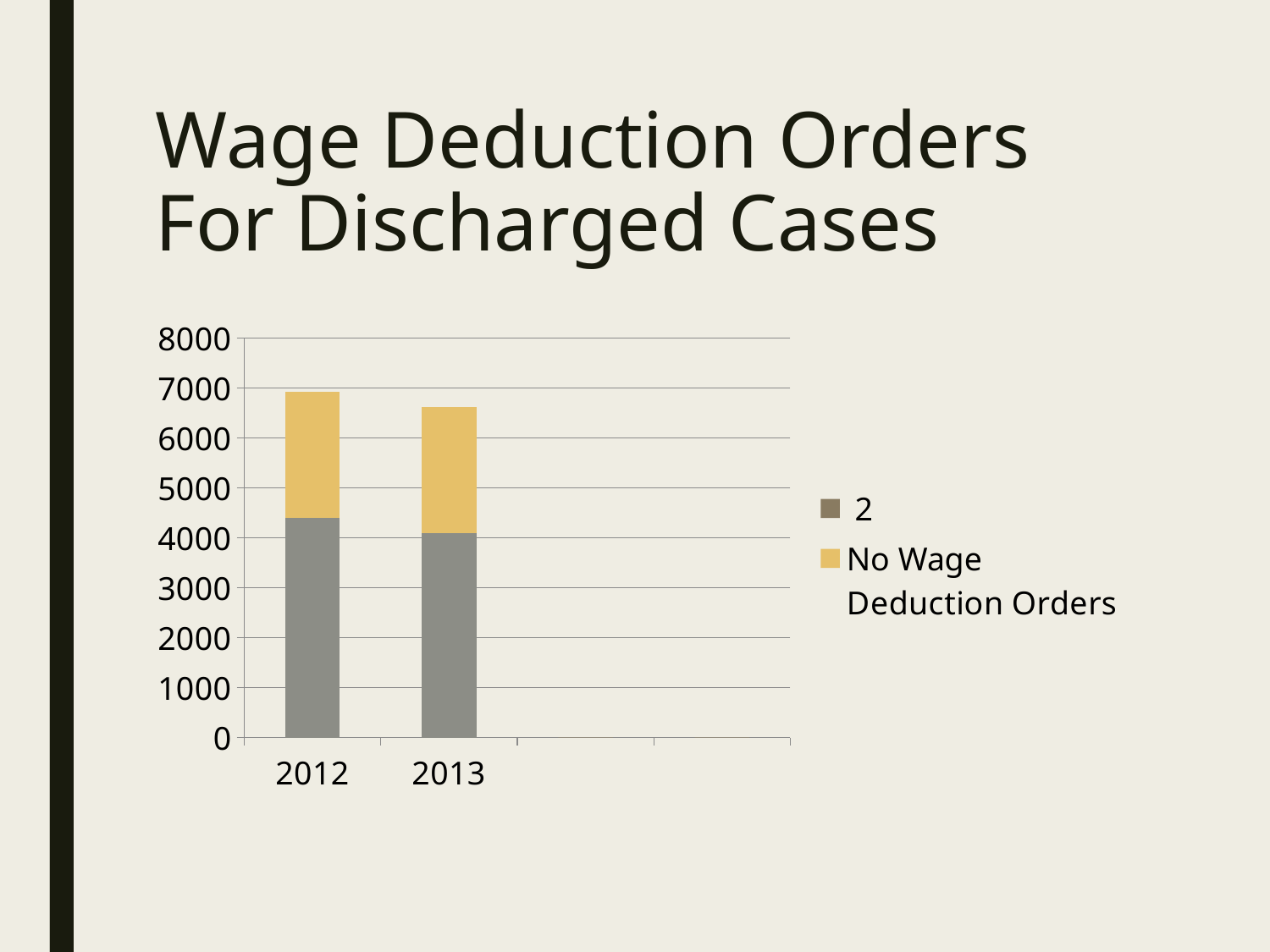
Is the total height of the stacked bar for 2013 greater or less than 6000? greater Do the total bar heights rise or fall from 2012 to 2013? fall Which years are shown on the x axis of the chart? 2012 and 2013 What is the label of the yellow series in the legend? No Wage Deduction Orders Is the total height of the stacked bar for 2012 greater or less than 6000? greater Is the value of the gray series for 2013 greater or less than 5000? less How many series does the chart's legend list? 2 How many categories are shown on the x axis of the chart? 2 What kind of chart is shown on the slide? stacked bar chart Which year has the taller stacked bar, 2012 or 2013? 2012